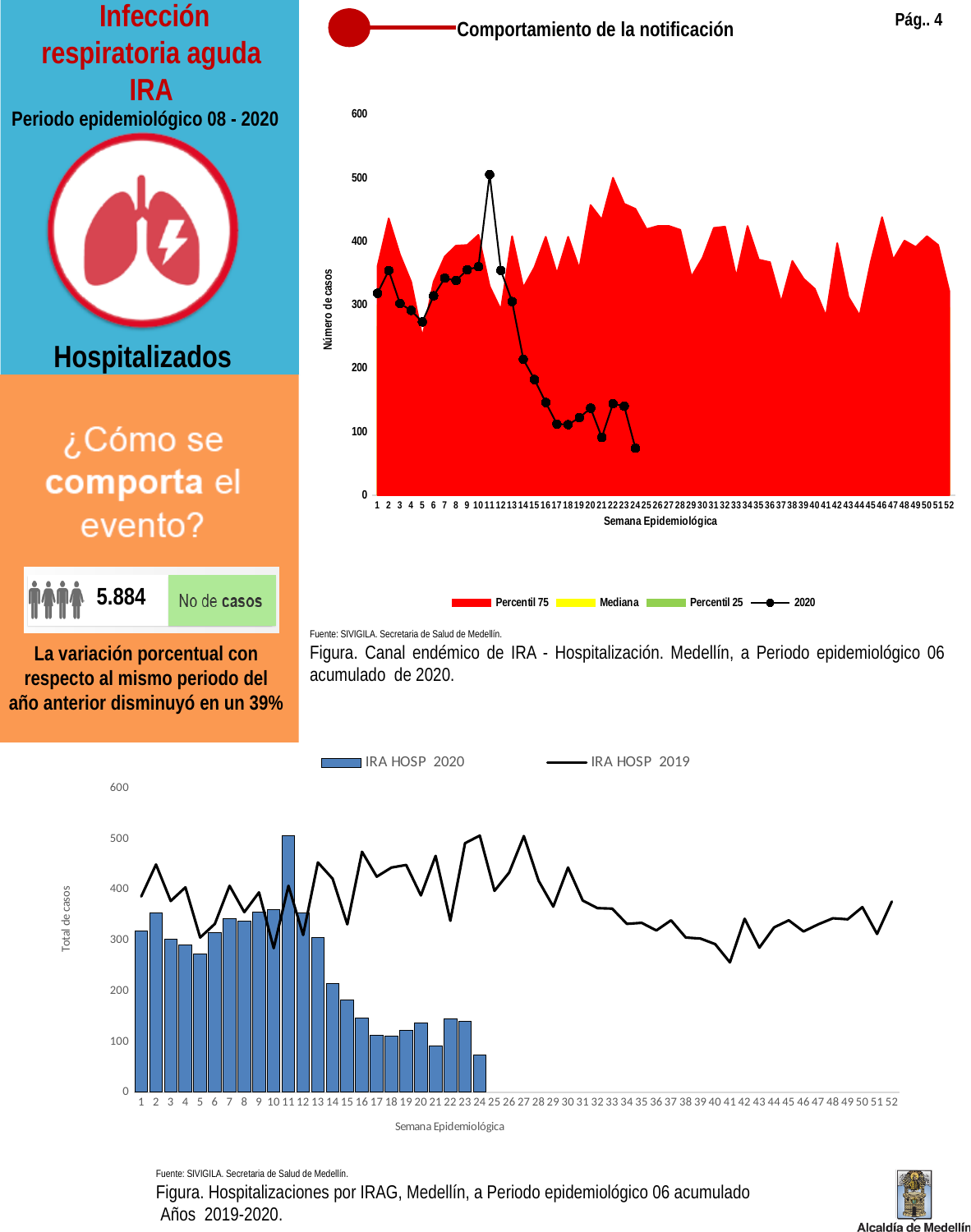
In the top chart (Canal endémico de IRA), is the 2020 value for week 16 greater or less than 200? less In the bottom chart (Hospitalizaciones por IRAG), is the IRA HOSP 2020 value for week 15 greater or less than 200? less In the top chart (Canal endémico de IRA), what is the label of the y axis? Número de casos In the top chart (Canal endémico de IRA), how many entries does the legend list? 4 In the top chart (Canal endémico de IRA), does the 2020 series rise or fall from week 11 to week 24? fall In the top chart (Canal endémico de IRA), which epidemiological week has the highest value for the 2020 series? 11 In the bottom chart (Hospitalizaciones por IRAG), which epidemiological week has the tallest IRA HOSP 2020 bar? 11 In the bottom chart (Hospitalizaciones por IRAG), how many epidemiological weeks are labeled on the x axis? 52 In the bottom chart (Hospitalizaciones por IRAG), which series is drawn as bars? IRA HOSP 2020 In the top chart (Canal endémico de IRA), is the 2020 value for week 11 greater or less than 400? greater In the bottom chart (Hospitalizaciones por IRAG), how many series does the legend list? 2